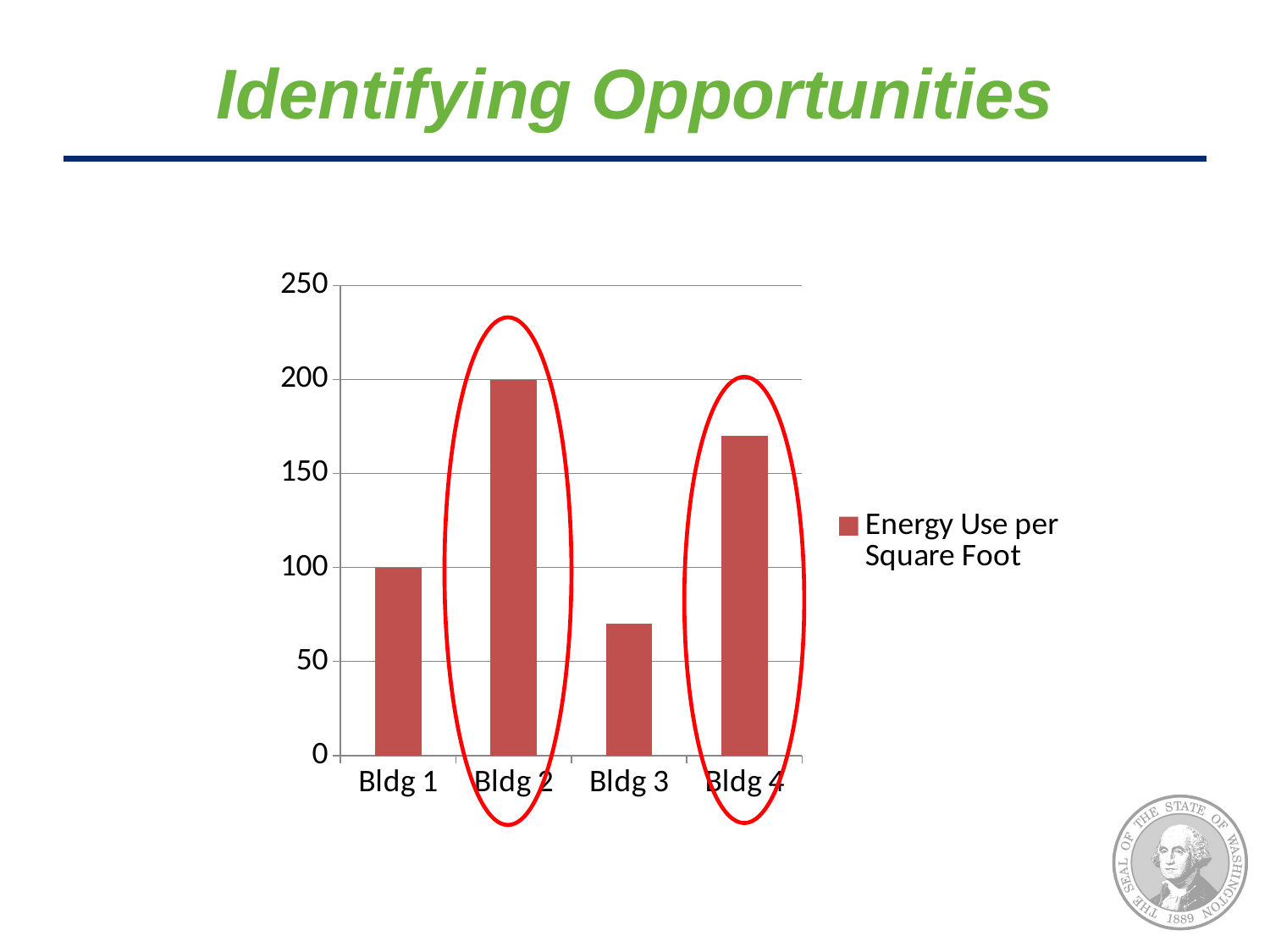
What is the Energy Use per Square Foot value for Bldg 1? 100 Is the Energy Use per Square Foot value for Bldg 4 greater or less than 150? greater Which building has the lowest Energy Use per Square Foot? Bldg 3 Which building has the highest Energy Use per Square Foot? Bldg 2 How many buildings (categories) are shown on the x axis of the chart? 4 What is the Energy Use per Square Foot value for Bldg 2? 200 Is the Energy Use per Square Foot value for Bldg 3 greater or less than 100? less How many series does the chart's legend list? 1 What is the name of the series shown in the chart's legend? Energy Use per Square Foot What is the difference in Energy Use per Square Foot between Bldg 2 and Bldg 1? 100 Which building has a higher Energy Use per Square Foot, Bldg 1 or Bldg 4? Bldg 4 What type of chart is shown on the slide? Bar chart